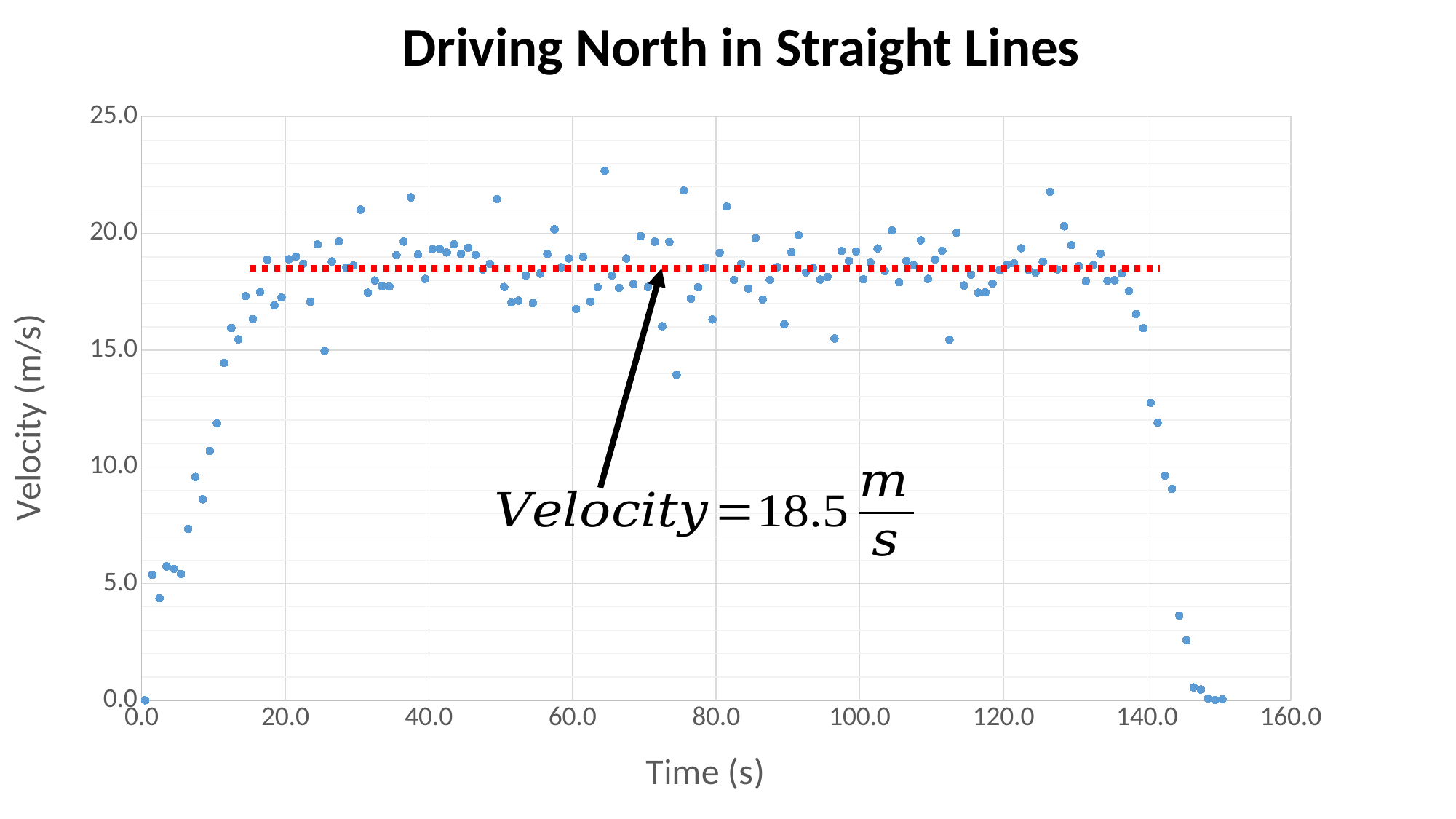
Does the velocity rise or fall between 0.0 s and 20.0 s? rise What is the maximum value shown on the velocity axis? 25.0 What is the label of the vertical axis? Velocity (m/s) What is the maximum value shown on the time axis? 160.0 Does the velocity rise or fall between 140.0 s and 150.0 s? fall Is the highest plotted velocity greater or less than 20.0? greater Is the velocity at time 0.0 s greater or less than 5.0? less What kind of chart is shown on the slide? scatter chart Is the velocity at time 150.0 s greater or less than 5.0? less What is the title of the chart? Driving North in Straight Lines What velocity does the red dotted line on the chart represent? 18.5 m/s